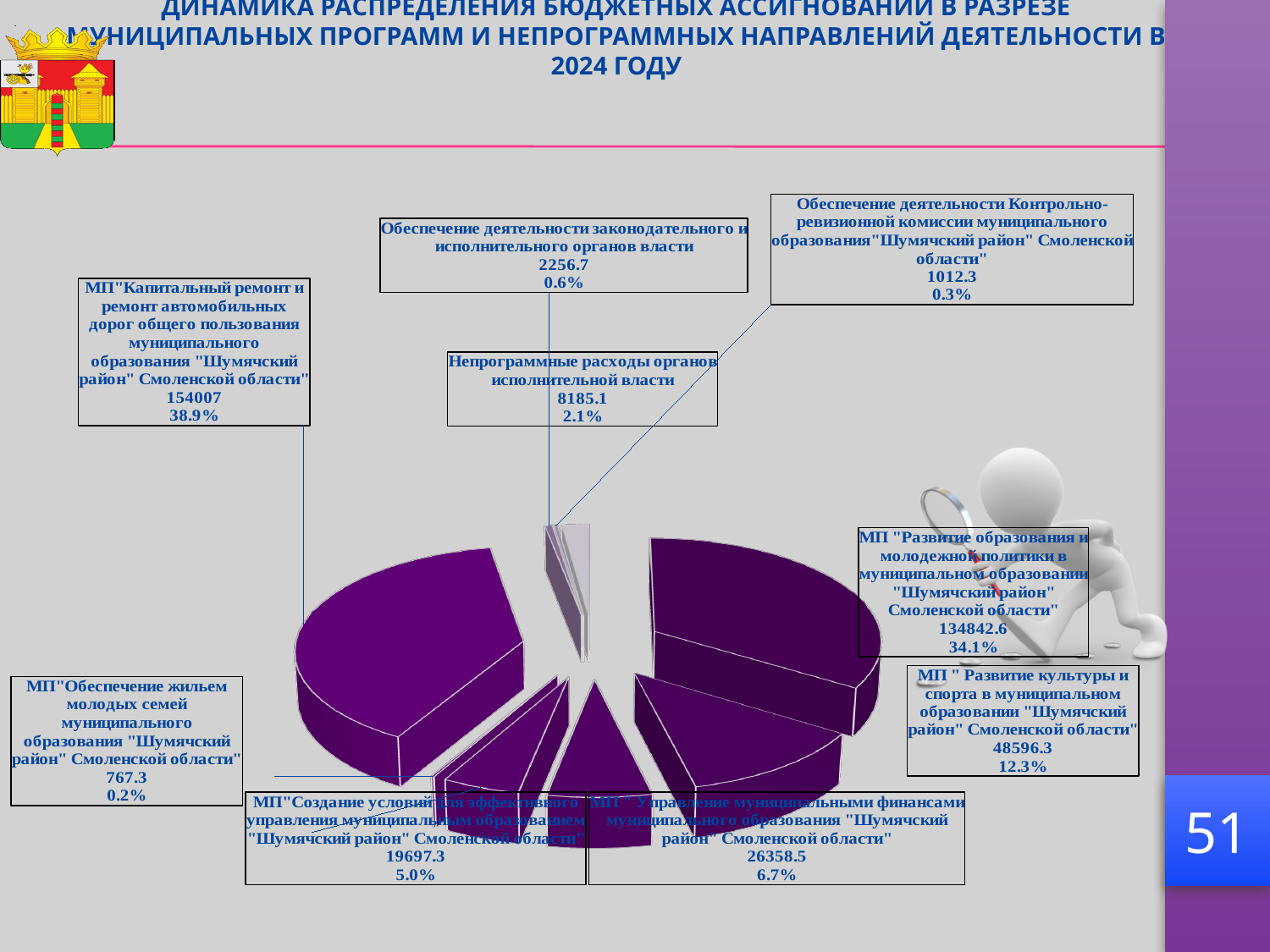
What kind of chart is shown on the slide? pie chart Which category has the smallest share of the pie? МП "Обеспечение жильем молодых семей" How many slices (categories) does the pie chart have? 9 What is the difference in percentage share between МП "Капитальный ремонт и ремонт автомобильных дорог" (38.9%) and МП "Развитие образования и молодежной политики" (34.1%)? 4.8% What value is shown for Непрограммные расходы органов исполнительной власти? 8185.1 What share of the pie does МП "Развитие образования и молодежной политики" have? 34.1% What value is shown for Обеспечение деятельности Контрольно-ревизионной комиссии? 1012.3 Which category has the largest share of the pie? МП "Капитальный ремонт и ремонт автомобильных дорог общего пользования" What share of the pie does Обеспечение деятельности законодательного и исполнительного органов власти have? 0.6% Which is larger: МП "Управление муниципальными финансами" or МП "Создание условий для эффективного управления"? МП "Управление муниципальными финансами" What share of the pie does МП "Развитие культуры и спорта" have? 12.3% What value is shown for МП "Капитальный ремонт и ремонт автомобильных дорог общего пользования"? 154007